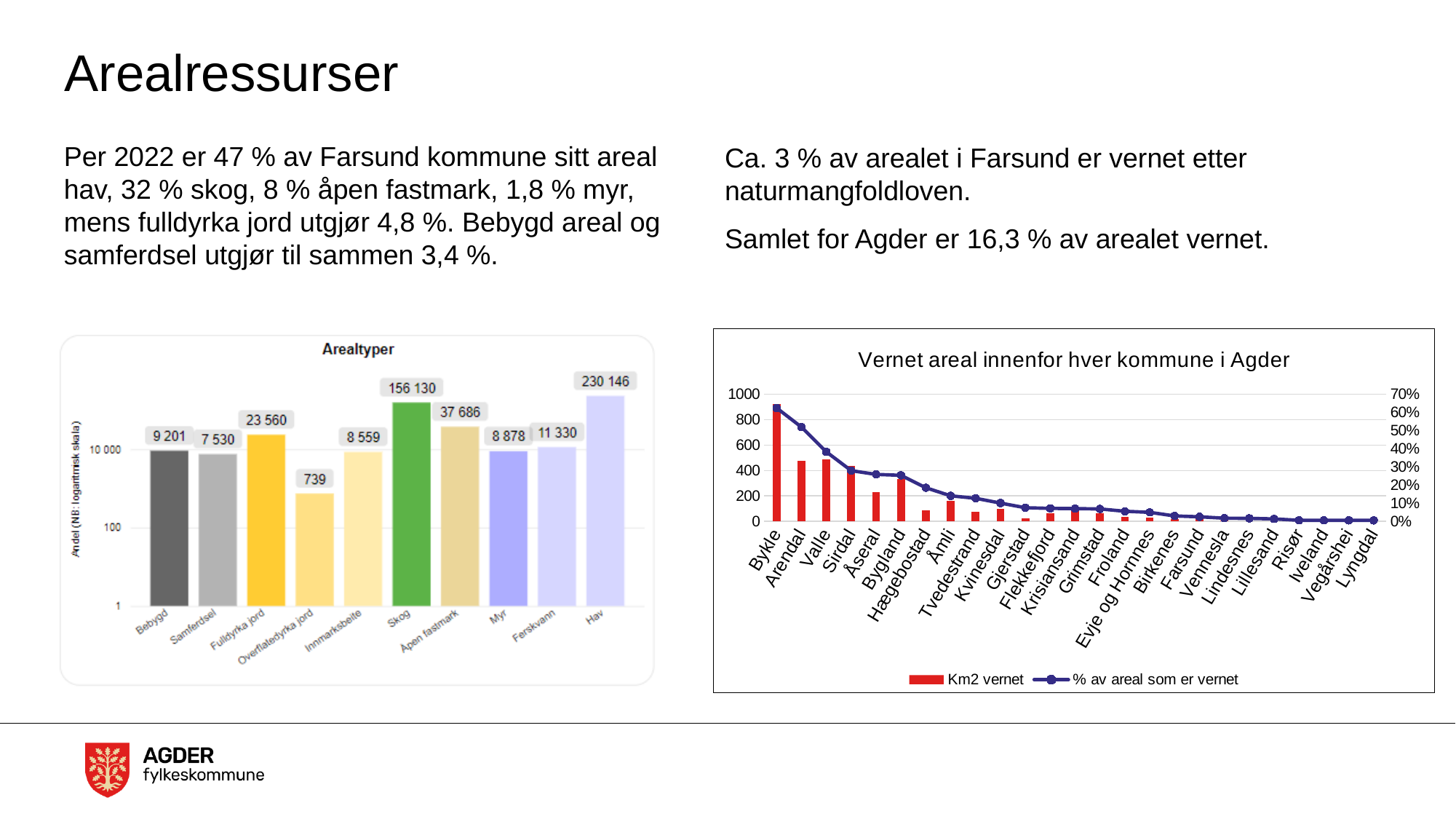
In the 'Vernet areal innenfor hver kommune i Agder' chart, which municipality has the highest Km2 vernet? Bykle In the 'Arealtyper' chart, which is larger, Bebygd or Samferdsel? Bebygd In the 'Arealtyper' chart, what is the value for Fulldyrka jord? 23 560 In the 'Arealtyper' chart, what is the difference between Hav and Skog? 74 016 In the 'Arealtyper' chart, what is the value for Skog? 156 130 In the 'Vernet areal innenfor hver kommune i Agder' chart, is the Km2 vernet value for Bykle greater or less than 800? greater In the 'Arealtyper' chart, which category has the lowest value? Overflatedyrka jord In the 'Arealtyper' chart, what is the value for Ferskvann? 11 330 How many series does the legend of the 'Vernet areal innenfor hver kommune i Agder' chart list? 2 How many categories are shown in the 'Arealtyper' chart? 10 How many municipalities are shown on the x axis of the 'Vernet areal innenfor hver kommune i Agder' chart? 25 In the 'Arealtyper' chart, which category has the highest value? Hav